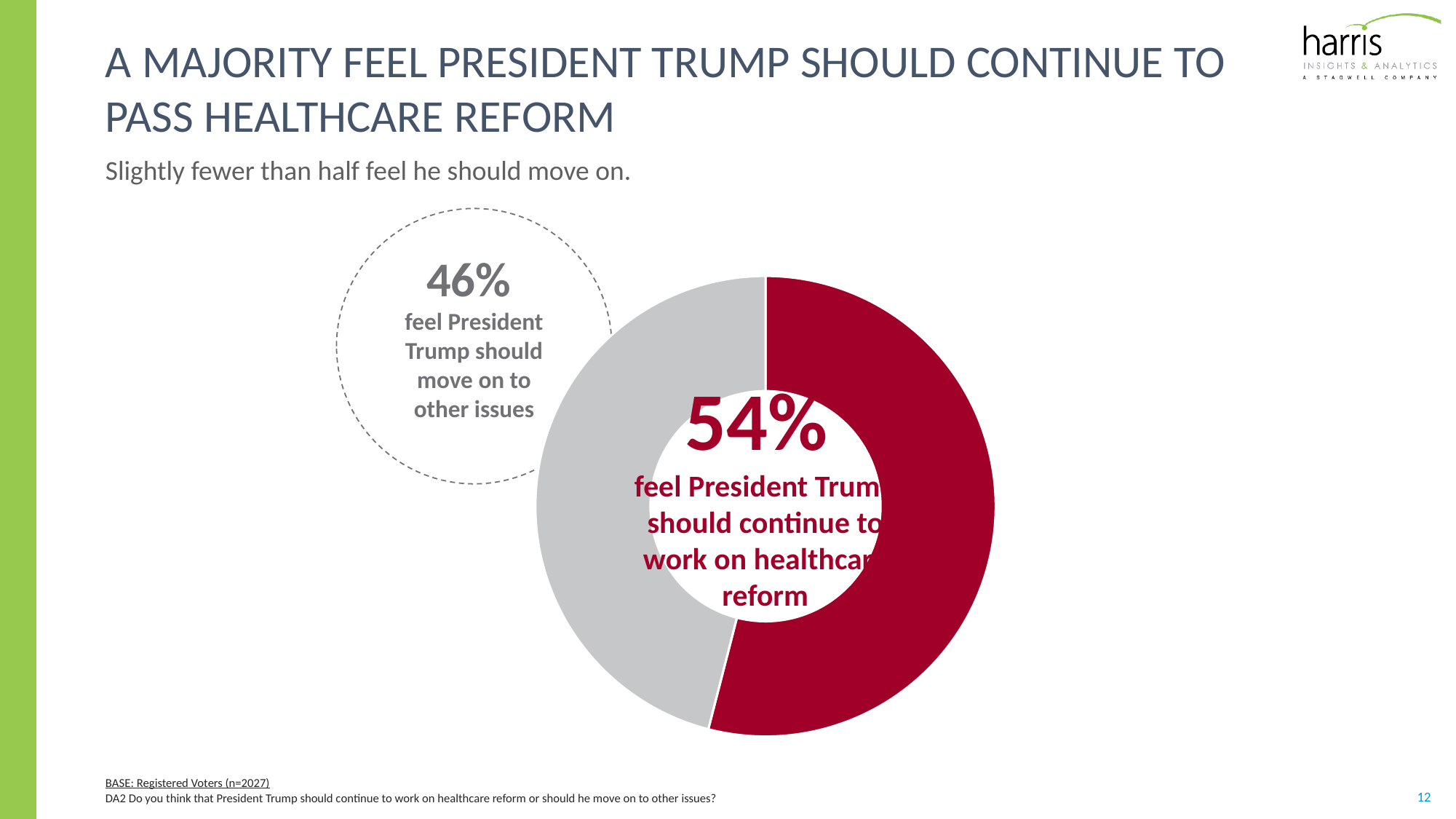
What is the difference in percentage points between those who feel Trump should continue on healthcare reform and those who feel he should move on? 8 What percentage feel President Trump should continue to work on healthcare reform? 54% Which response has the larger share: continue to work on healthcare reform or move on to other issues? Continue to work on healthcare reform Is the share for 'continue to work on healthcare reform' larger or smaller than the share for 'move on to other issues'? Larger Is the share of respondents who feel Trump should move on to other issues greater or less than 50%? Less What kind of chart is shown on the slide? Doughnut (pie) chart Which response has the smaller share of the chart? Move on to other issues How many segments does the chart have? 2 What is the base sample size shown for the chart? Registered Voters (n=2027) What colour is the segment representing those who feel Trump should continue to work on healthcare reform? Red What percentage feel President Trump should move on to other issues? 46% What is the total of the two percentages shown in the chart? 100%